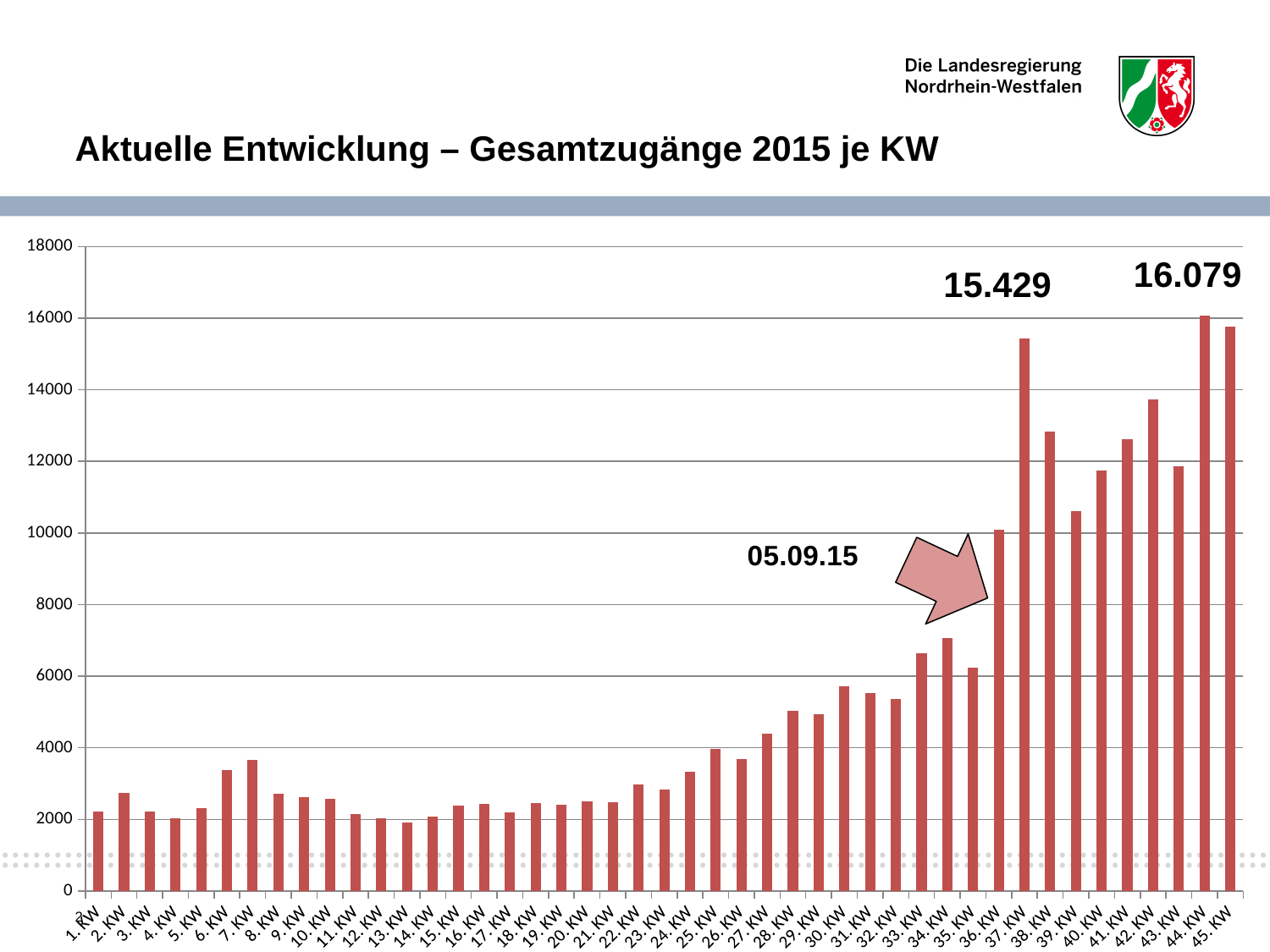
What date is written next to the arrow on the chart? 05.09.15 How many calendar weeks are shown on the x axis? 45 What is the value for 44. KW? 16.079 What is the difference between the values for 44. KW and 37. KW? 650 What is the value for 37. KW? 15.429 Which has a larger value, 37. KW or 38. KW? 37. KW Is the value for 42. KW greater or less than 14000? less Is the value for 38. KW greater or less than 12000? greater Which calendar week has the highest value? 44. KW What kind of chart is shown on the slide? bar chart Which has a larger value, 6. KW or 7. KW? 7. KW Is the value for 28. KW greater or less than 4000? greater